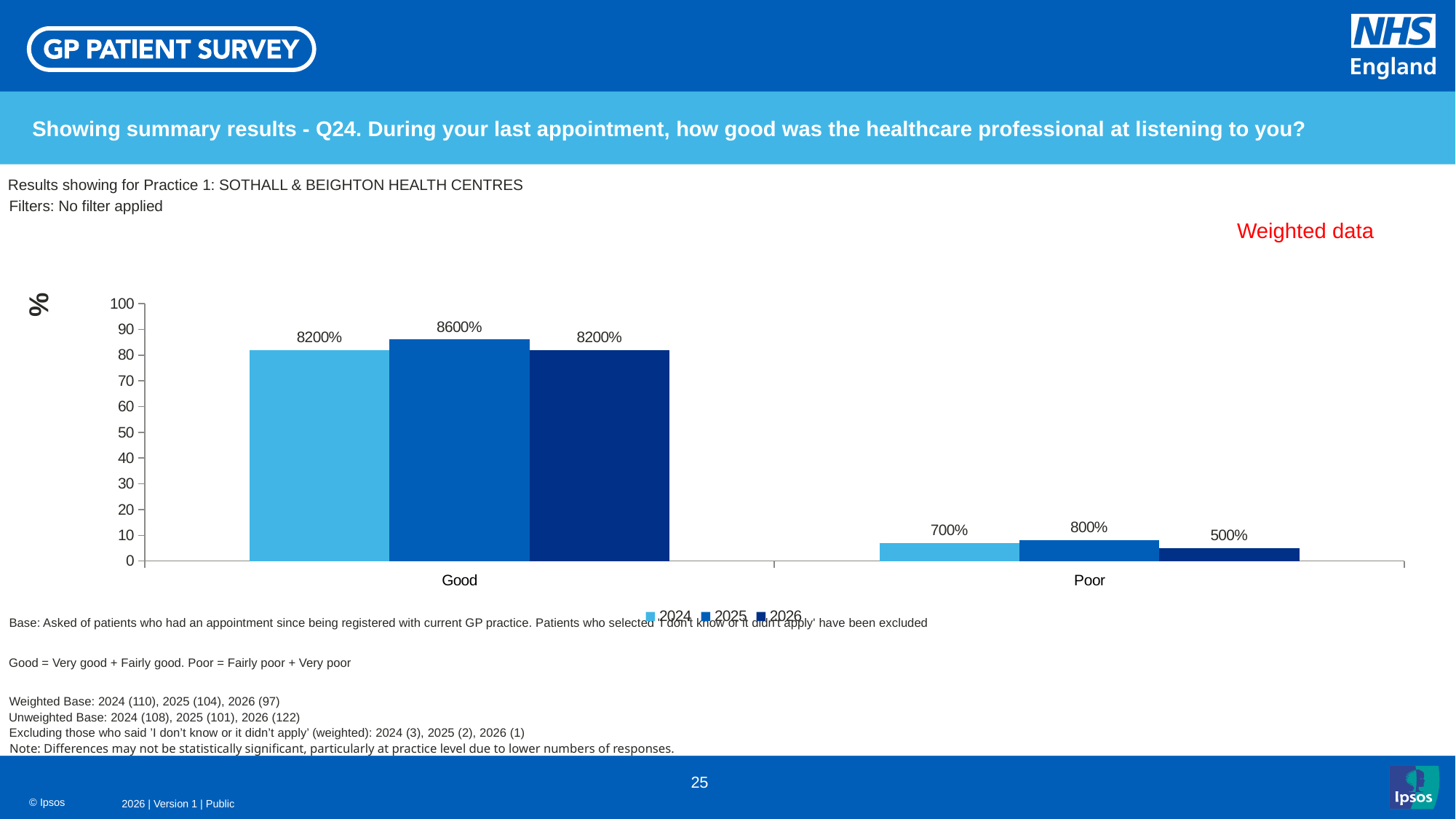
What is the data label shown for the 2026 series in the Poor category? 500% How many series does the legend list? 3 Is the 2025 bar in the Good category greater or less than 80 on the axis? greater Which year has the highest bar in the Good category? 2025 What is the data label shown for the 2025 series in the Good category? 8600% Which year has the lowest bar in the Poor category? 2026 Which is larger in the Poor category: the 2025 bar or the 2026 bar? 2025 What is the data label shown for the 2024 series in the Good category? 8200% What kind of chart is shown on the slide? Bar chart Is the 2025 bar in the Poor category greater or less than 10 on the axis? less What is the data label shown for the 2024 series in the Poor category? 700% How many categories are shown on the x axis? 2